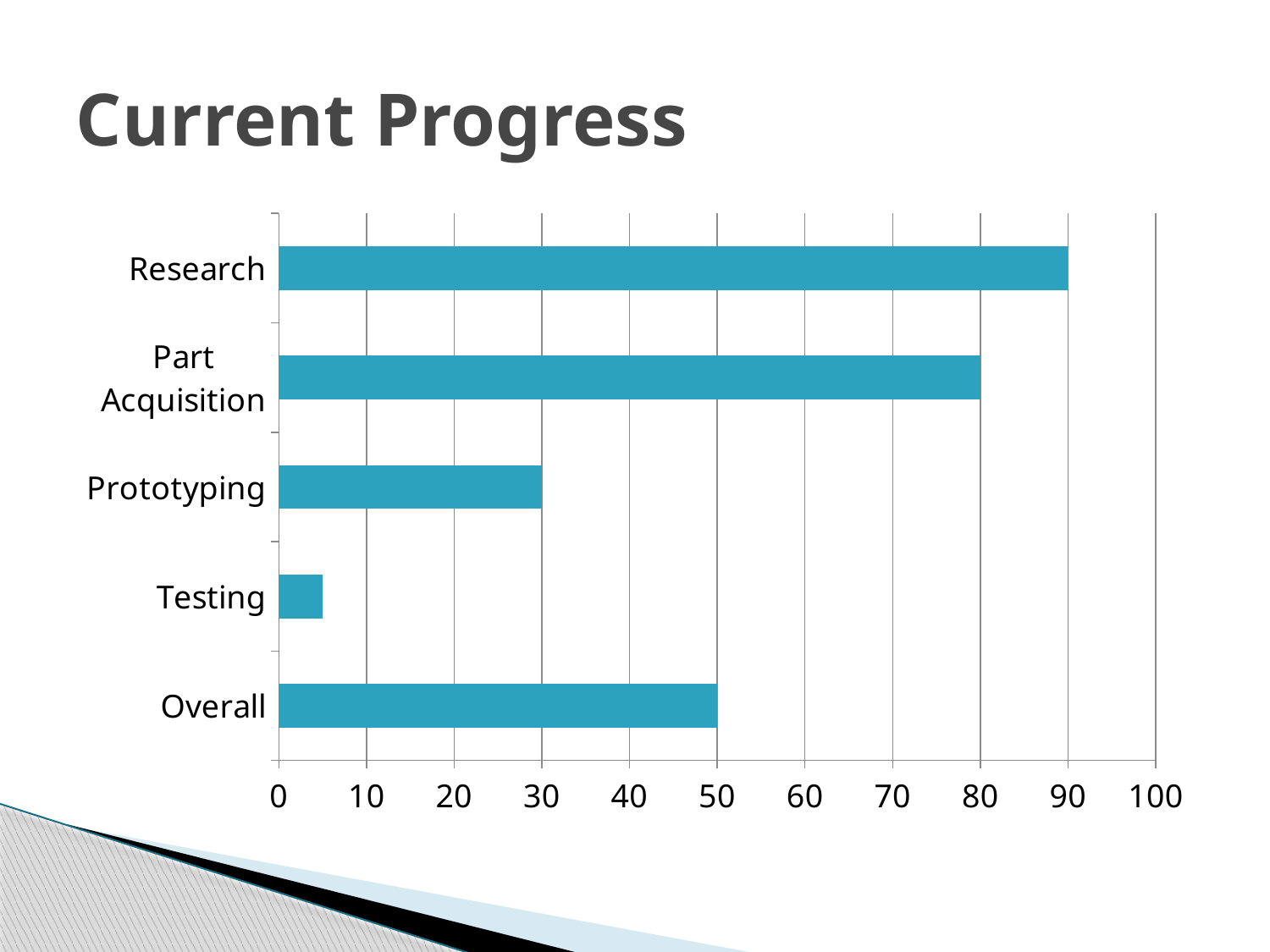
Which is larger, the value for Prototyping or the value for Overall? Overall What kind of chart is shown on the slide? bar chart Which category has the lowest value? Testing How many categories are shown in the chart? 5 What is the value for Part Acquisition? 80 Is the value for Testing greater or less than 10? less What is the difference between the values for Overall and Prototyping? 20 What is the value for Research? 90 What is the difference between the values for Research and Part Acquisition? 10 What is the value for Overall? 50 Which category has the highest value? Research What is the value for Prototyping? 30